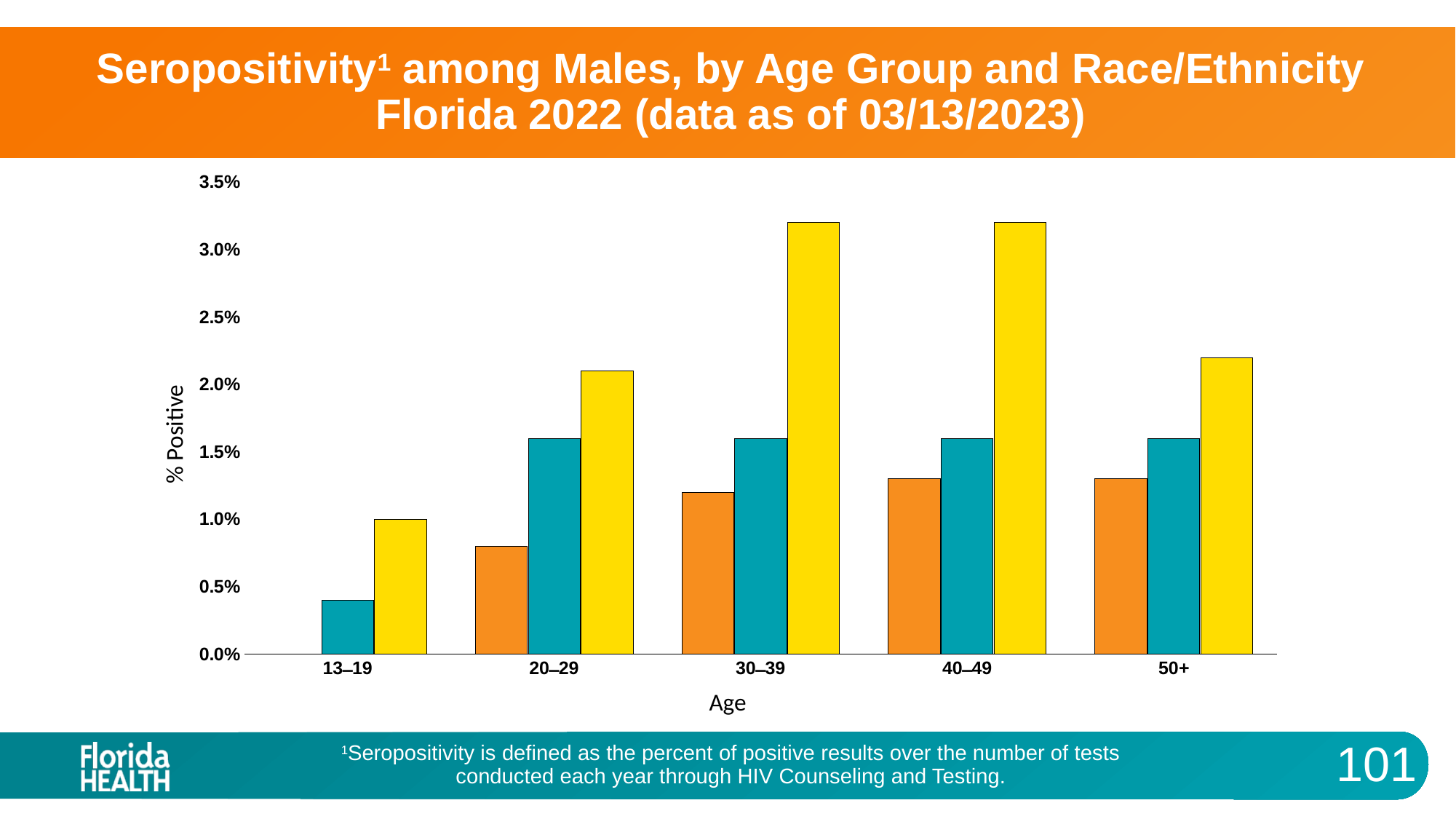
In the 20–29 age group, which bar is taller, the yellow bar or the teal bar? the yellow bar What kind of chart is shown on the slide? bar chart Is the value of the orange bar for the 20–29 age group greater or less than 1.0%? less How many bars are plotted for the 13–19 age group? 2 How many age groups are shown on the x axis? 5 Which age group has the lowest bar on the chart? 13–19 What is the label on the y axis of the chart? % Positive Do the yellow bars rise or fall from the 13–19 age group to the 30–39 age group? rise Which is larger, the yellow bar for 13–19 or the yellow bar for 20–29? the yellow bar for 20–29 Is the value of the yellow bar for the 50+ age group greater or less than 2.0%? greater Is the value of the teal bar for the 13–19 age group greater or less than 0.5%? less